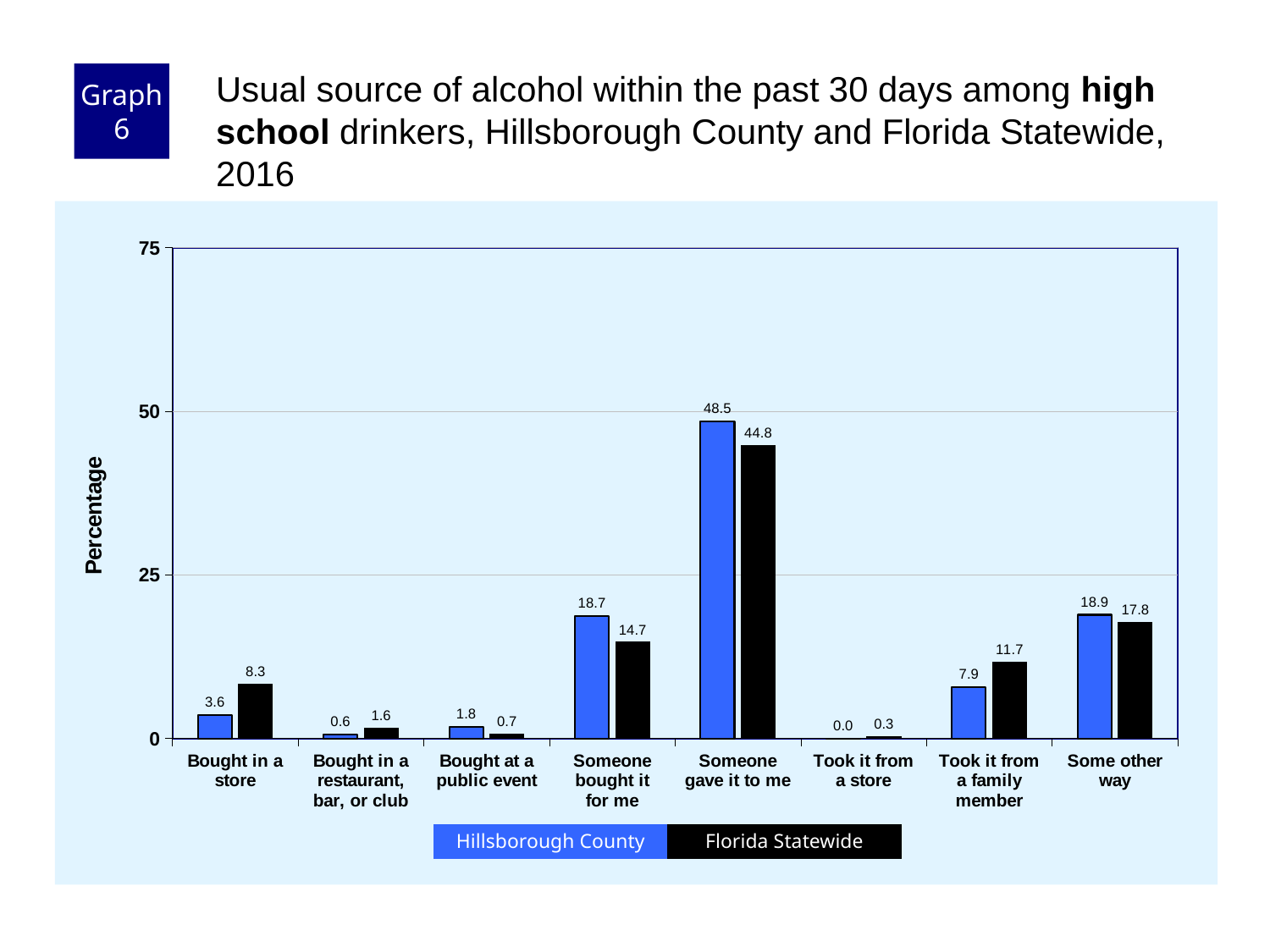
Which category has the highest Florida Statewide value? Someone gave it to me What is the Hillsborough County value for "Bought in a store"? 3.6 Is the Florida Statewide value for "Someone gave it to me" greater or less than 25? greater What is the difference between the Hillsborough County and Florida Statewide values for "Someone bought it for me"? 4.0 How many categories are shown on the x axis? 8 Which category has the lowest Hillsborough County value? Took it from a store What is the Florida Statewide value for "Took it from a family member"? 11.7 Which is larger for "Bought in a store": Hillsborough County or Florida Statewide? Florida Statewide How many series does the legend list? 2 What kind of chart is shown on the slide? Bar chart What is the label of the y axis? Percentage What is the Hillsborough County value for "Someone gave it to me"? 48.5